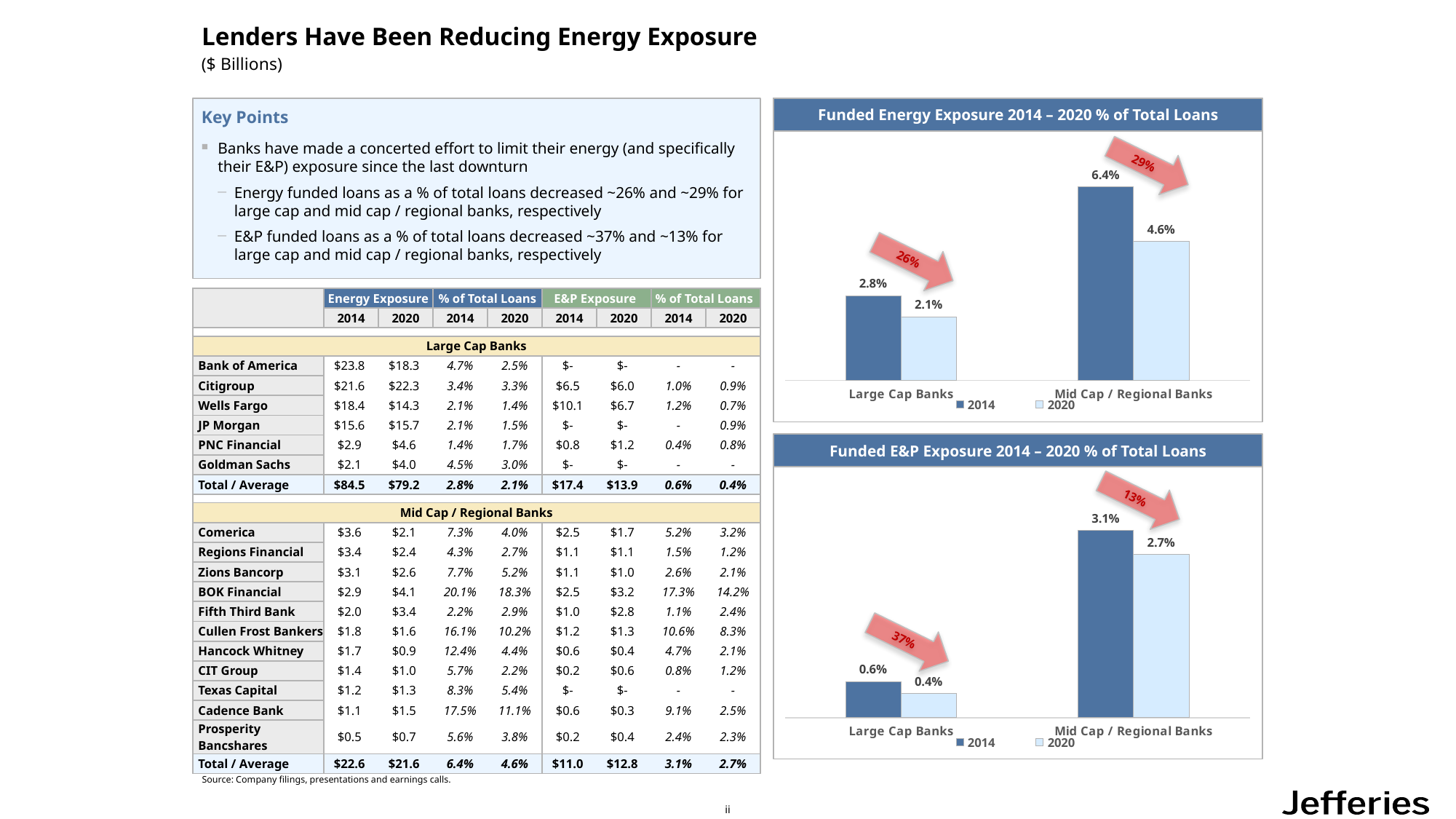
In the Funded E&P Exposure chart, which bar is the lowest? Large Cap Banks 2020 In the Funded Energy Exposure chart, what is the 2014 value for Large Cap Banks? 2.8% How many series does the legend list in the Funded E&P Exposure chart? 2 What kind of chart is the Funded Energy Exposure chart? bar chart In the Funded Energy Exposure chart, what is the difference between the 2014 and 2020 values for Mid Cap / Regional Banks? 1.8% In the Funded E&P Exposure chart, what is the difference between the 2014 and 2020 values for Large Cap Banks? 0.2% In the Funded Energy Exposure chart, what is the 2020 value for Mid Cap / Regional Banks? 4.6% In the Funded Energy Exposure chart, is the 2020 value for Large Cap Banks larger or smaller than the 2020 value for Mid Cap / Regional Banks? smaller In the Funded E&P Exposure chart, what is the 2020 value for Large Cap Banks? 0.4% In the Funded E&P Exposure chart, what percentage decrease is shown by the red arrow over Mid Cap / Regional Banks? 13% In the Funded E&P Exposure chart, what is the 2014 value for Mid Cap / Regional Banks? 3.1% In the Funded Energy Exposure chart, which bar is the highest? Mid Cap / Regional Banks 2014